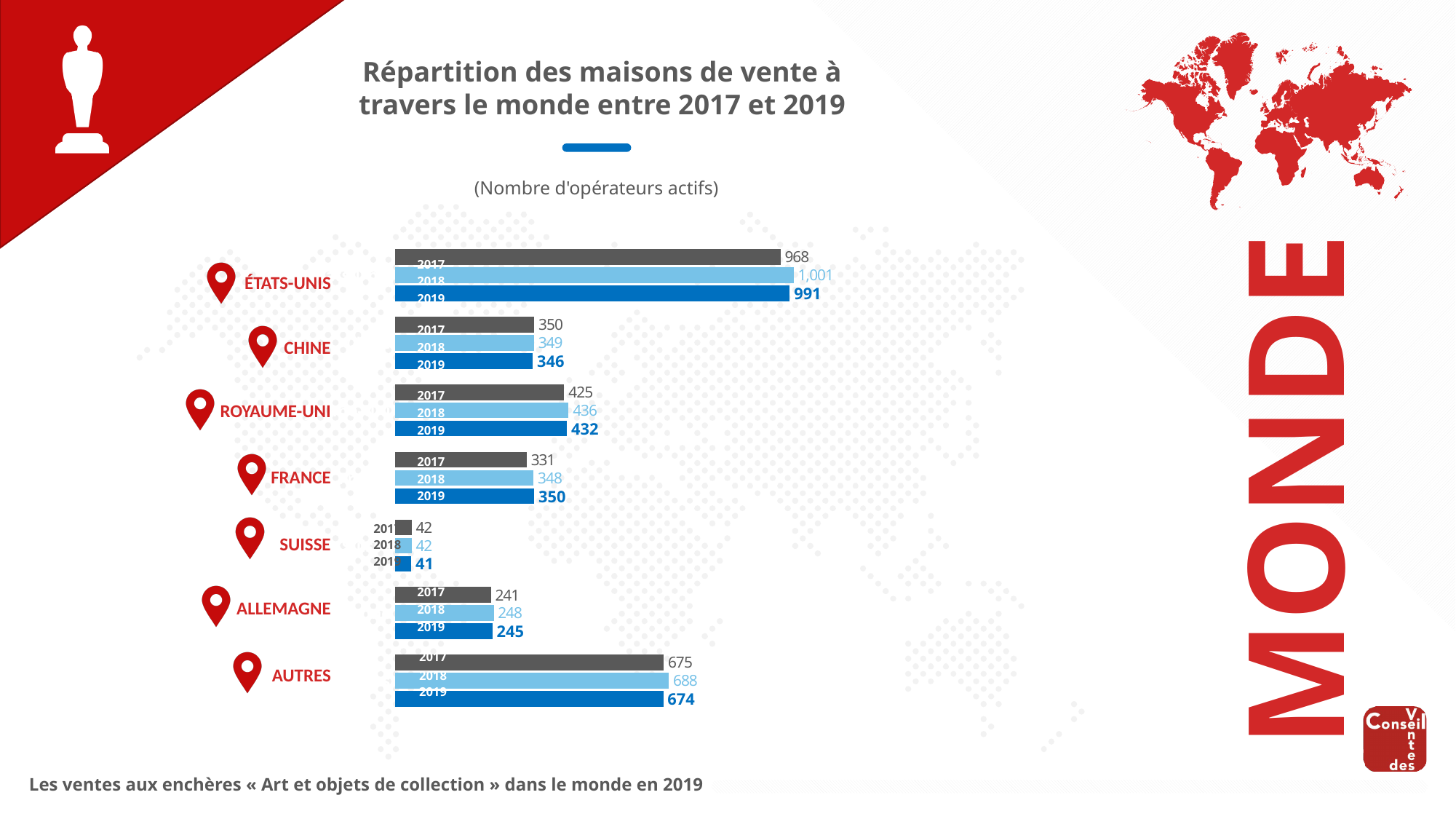
What is the value for Suisse in 2019? 41 What is the value for Chine in 2019? 346 What type of chart is shown on the slide? bar chart How many countries or regions are shown in the chart? 7 What is the difference between the 2018 and 2017 values for France? 17 What is the value for Royaume-Uni in 2017? 425 Which is larger, the 2019 value for Allemagne or the 2019 value for France? France Which country has the highest value in 2019? États-Unis How many years (series) are plotted for each country? 3 Which country has the lowest value in 2017? Suisse What is the title of the chart? Répartition des maisons de vente à travers le monde entre 2017 et 2019 What is the value for États-Unis in 2018? 1,001